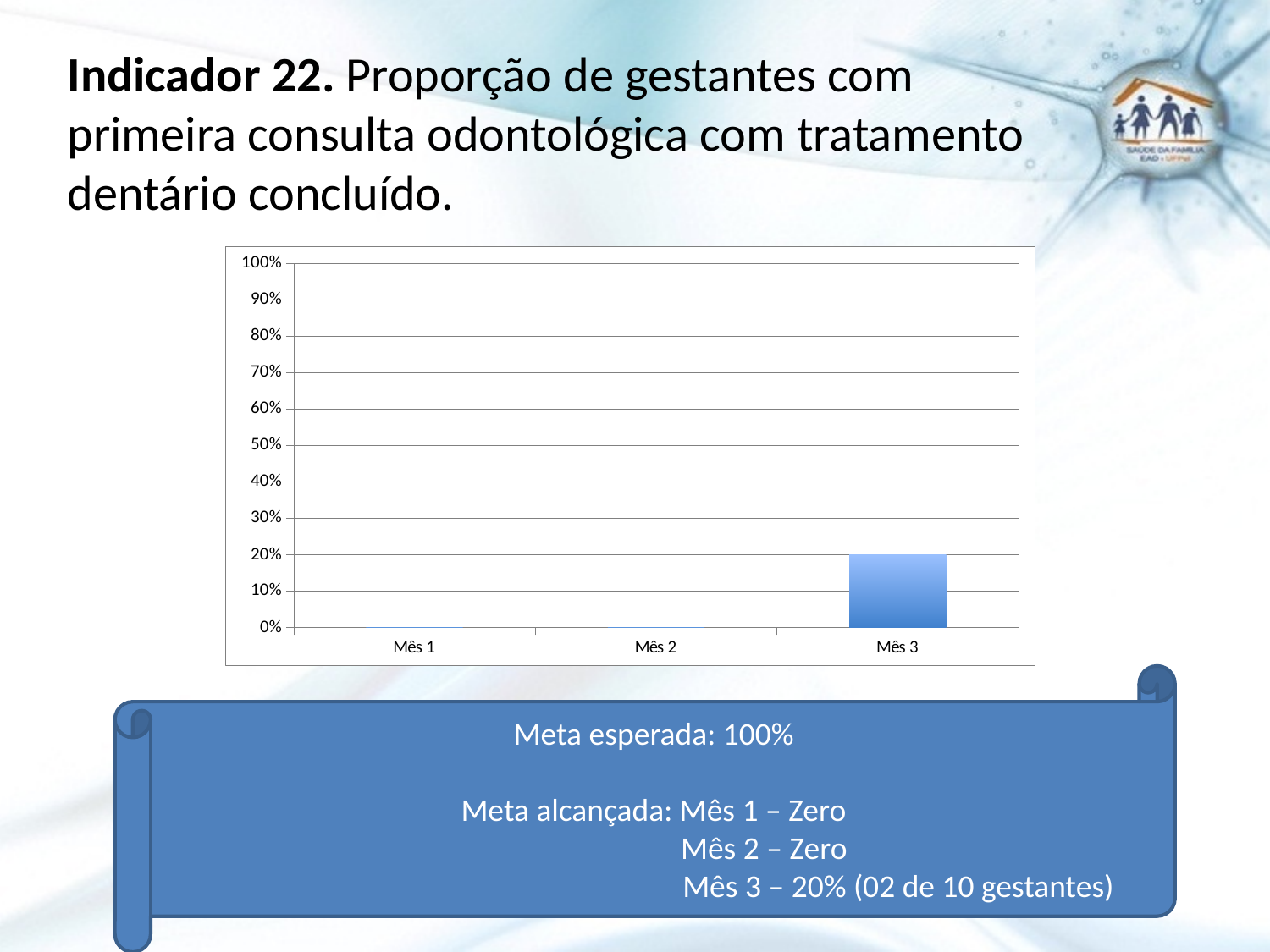
Which month has the highest value in the chart? Mês 3 What is the value for Mês 1 in the chart? 0% What is the value for Mês 3 in the chart? 20% Do the values rise or fall from Mês 1 to Mês 3? rise What is the highest value shown on the y axis of the chart? 100% Is the value for Mês 3 greater or less than 50%? less What kind of chart is shown on the slide? bar chart Is the value for Mês 3 greater or less than 10%? greater Which is larger, the value for Mês 2 or the value for Mês 3? Mês 3 How many categories are shown on the x axis of the chart? 3 What is the difference between the value for Mês 3 and the value for Mês 1? 20% What is the value for Mês 2 in the chart? 0%